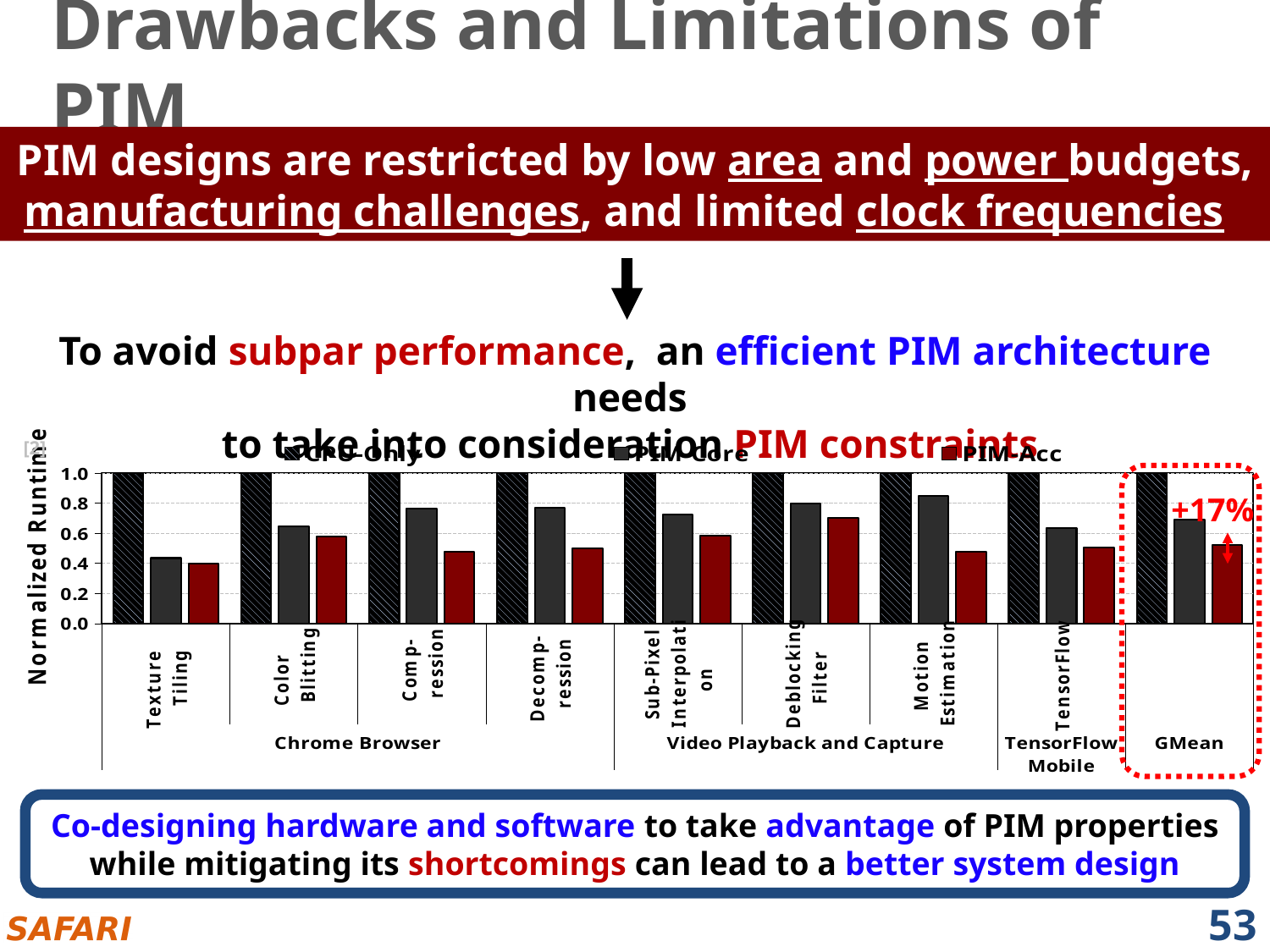
Among the PIM-Acc bars, which workload has the lowest Normalized Runtime? Texture Tiling What is the Normalized Runtime value of the CPU-Only bar for Texture Tiling? 1.0 What kind of chart is shown on the slide? bar chart How many series does the chart's legend list? 3 For Compression, which is larger: the PIM-Core bar or the PIM-Acc bar? PIM-Core What is the title of the chart's y axis? Normalized Runtime Is the PIM-Core value for Compression greater or less than 0.6? greater Is the PIM-Acc value for Motion Estimation greater or less than 0.6? less How many workload categories (including GMean) are plotted along the x axis? 9 Is the PIM-Core value for Color Blitting greater or less than 0.8? less What is the Normalized Runtime value of the CPU-Only bar for GMean? 1.0